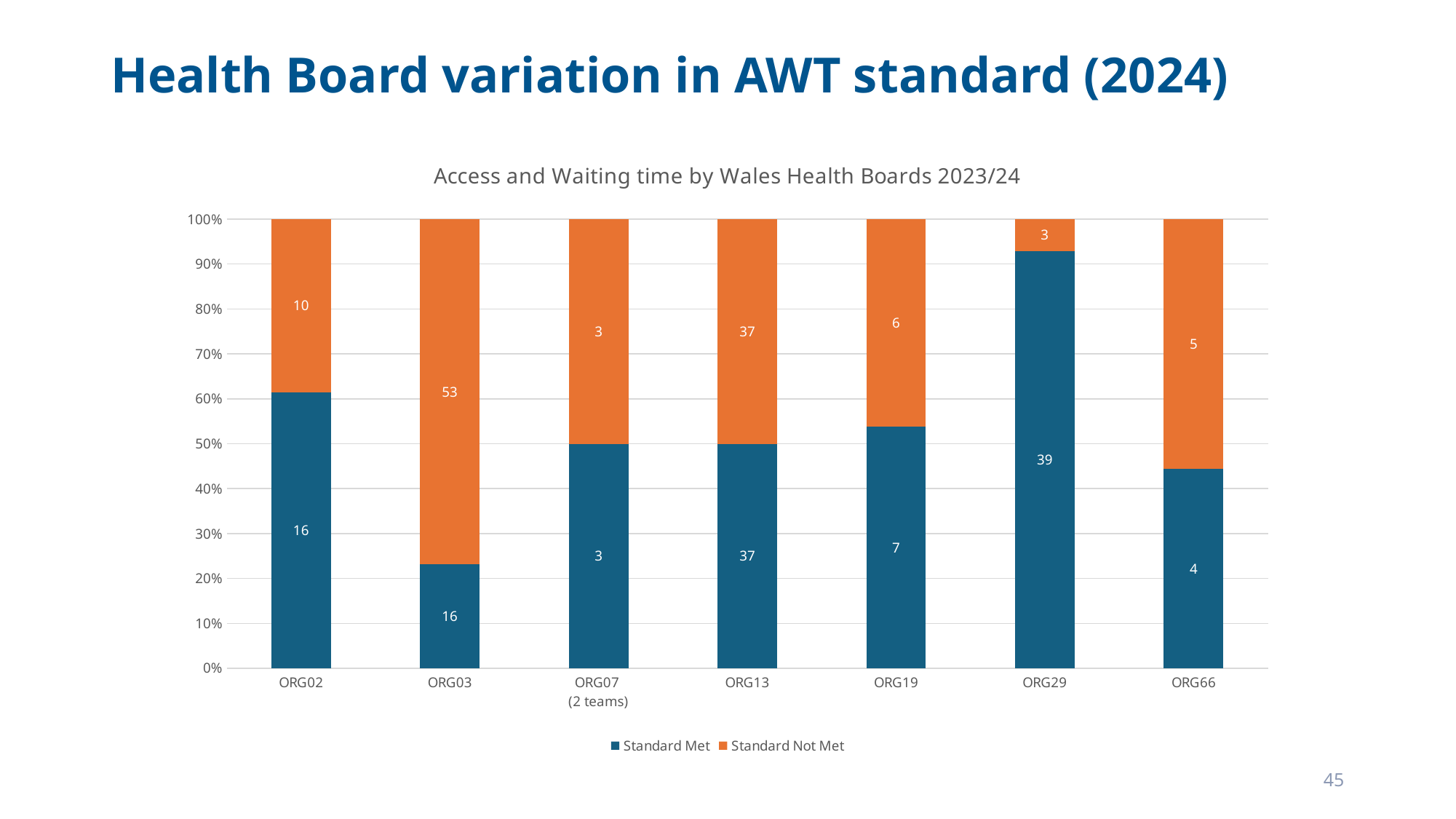
What is the Standard Not Met value for ORG13? 37 Is the Standard Met share for ORG03 greater or less than 30%? less Which is larger for ORG66, Standard Met or Standard Not Met? Standard Not Met Which category has the highest Standard Not Met value? ORG03 What is the difference between the Standard Not Met and Standard Met values for ORG03? 37 What is the Standard Met value for ORG29? 39 What kind of chart is shown on the slide? Stacked bar chart How many series does the legend list? 2 What is the Standard Met value for ORG03? 16 How many categories are shown on the x axis? 7